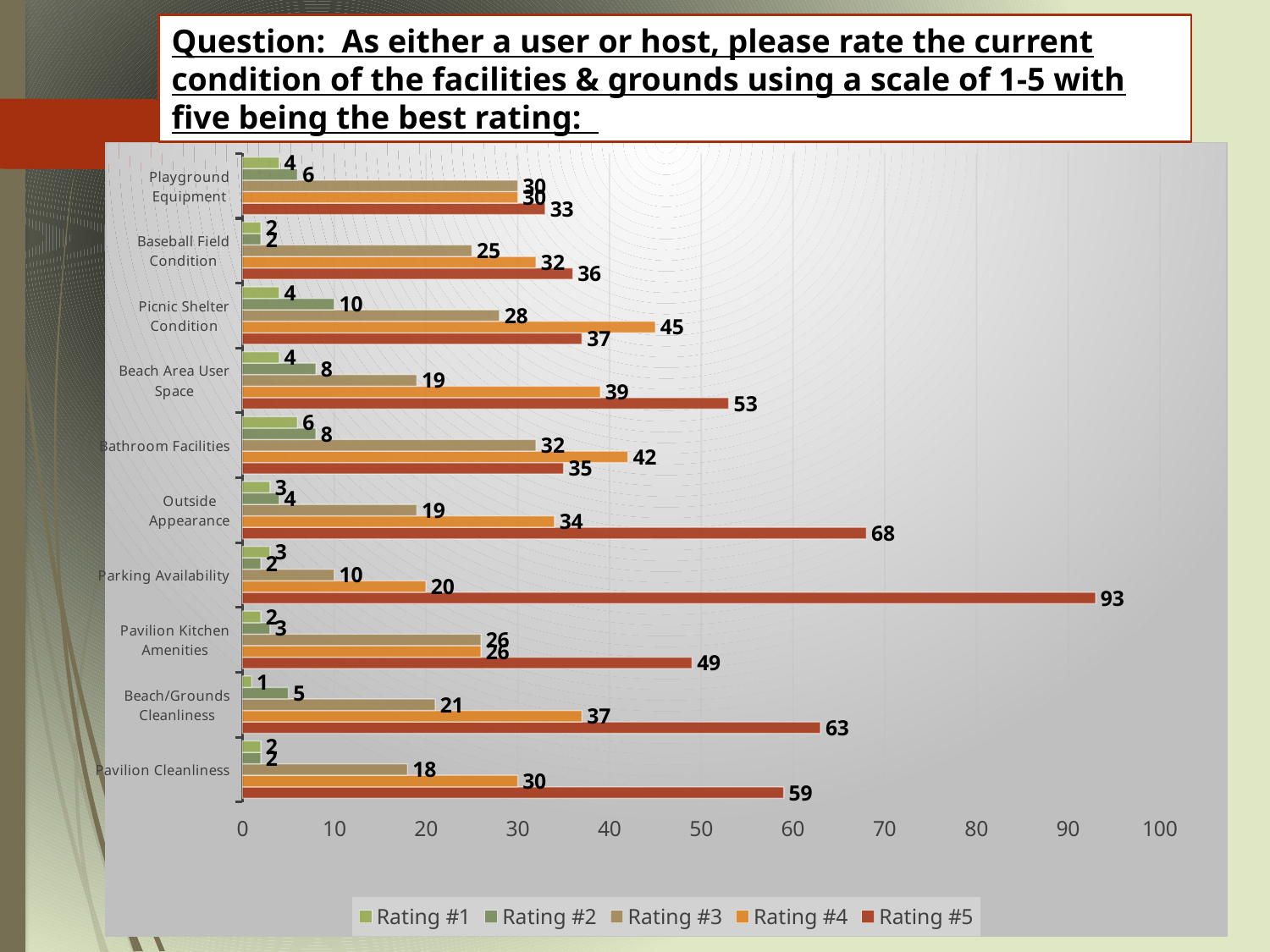
Which category has the highest Rating #5 value? Parking Availability Which is larger for Bathroom Facilities: the Rating #4 value or the Rating #5 value? Rating #4 What is the total of the five rating values for Pavilion Kitchen Amenities? 106 How many categories are shown on the chart? 10 What is the difference between the Rating #5 values for Outside Appearance and Beach/Grounds Cleanliness? 5 Is the Rating #5 value for Beach Area User Space greater or less than 50? greater How many series does the legend list? 5 What kind of chart is shown on the slide? Bar chart What is the Rating #3 value for Pavilion Cleanliness? 18 Which category has the lowest Rating #1 value? Beach/Grounds Cleanliness What is the Rating #4 value for Picnic Shelter Condition? 45 What is the Rating #5 value for Parking Availability? 93